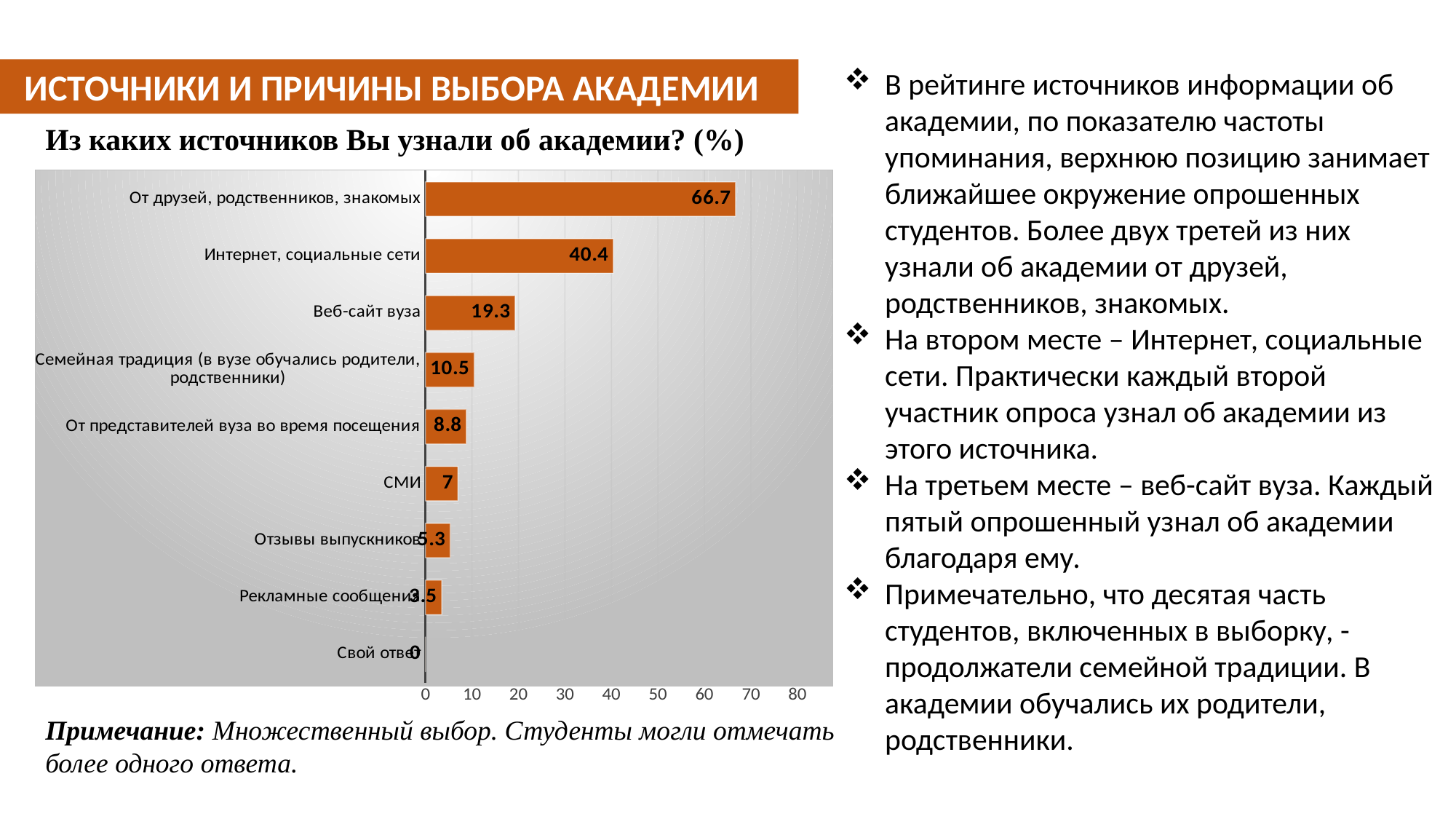
What value is shown for «СМИ»? 7 What value is shown for «От друзей, родственников, знакомых»? 66.7 Which category has the lowest value? Свой ответ What value is shown for «Веб-сайт вуза»? 19.3 What is the difference between the values for «От друзей, родственников, знакомых» and «Интернет, социальные сети»? 26.3 Which source has the highest value? От друзей, родственников, знакомых How many categories are shown in the chart? 9 What kind of chart is shown on the slide? Bar chart What is the title of the chart? Из каких источников Вы узнали об академии? (%) Which is larger: the value for «От представителей вуза во время посещения» or for «СМИ»? От представителей вуза во время посещения What value is shown for «Интернет, социальные сети»? 40.4 What value is shown for «Семейная традиция (в вузе обучались родители, родственники)»? 10.5